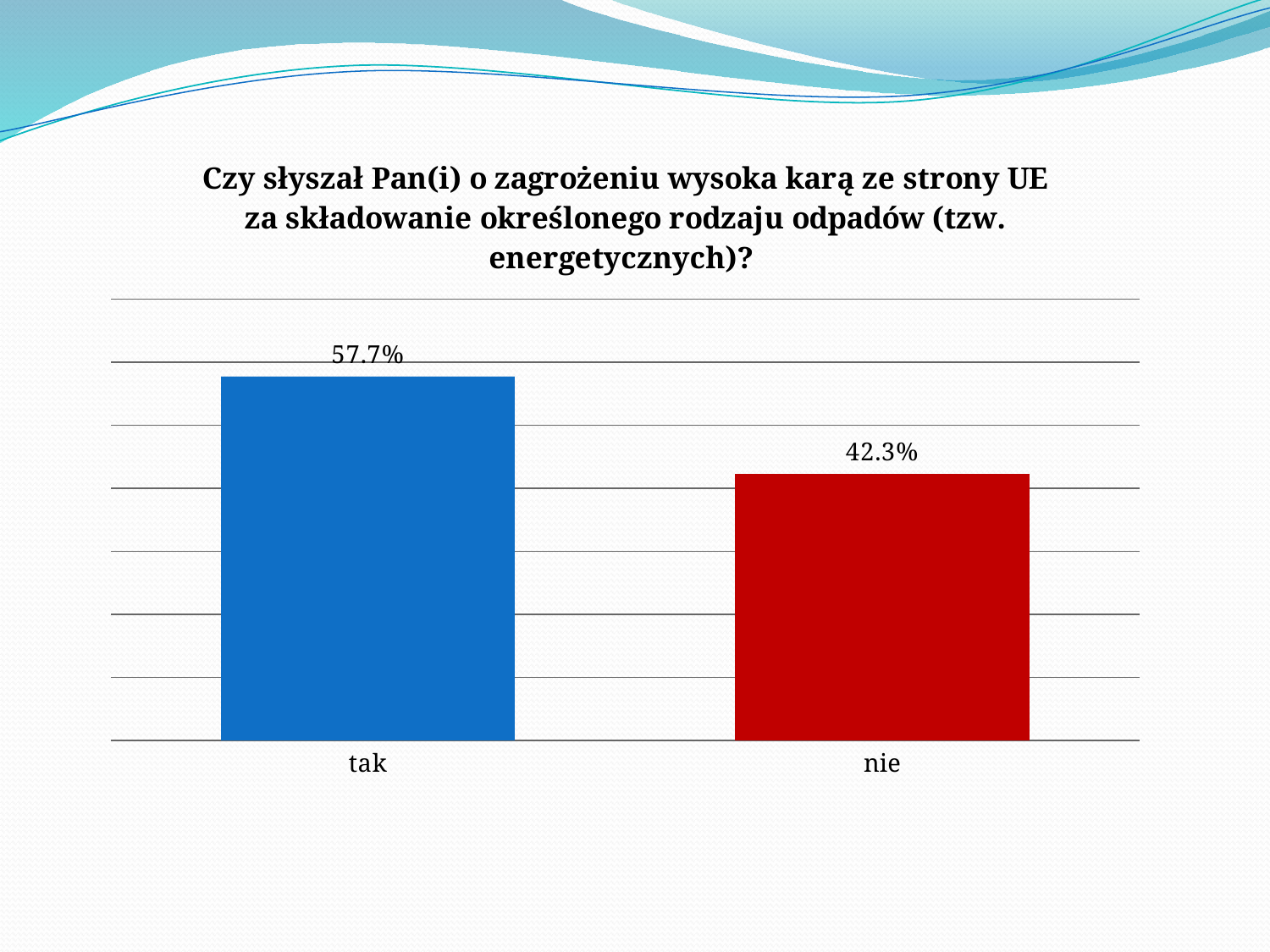
How many categories are shown in the chart? 2 What kind of chart is shown on the slide? bar chart What is the total of the two values shown in the chart? 100% What is the difference between the values for "tak" and "nie"? 15.4% What is the value for "nie"? 42.3% Which category has the lowest value? nie Which category has the highest value? tak What is the value for "tak"? 57.7% What colour is the bar for "nie"? red What colour is the bar for "tak"? blue Which is larger, the value for "tak" or the value for "nie"? tak